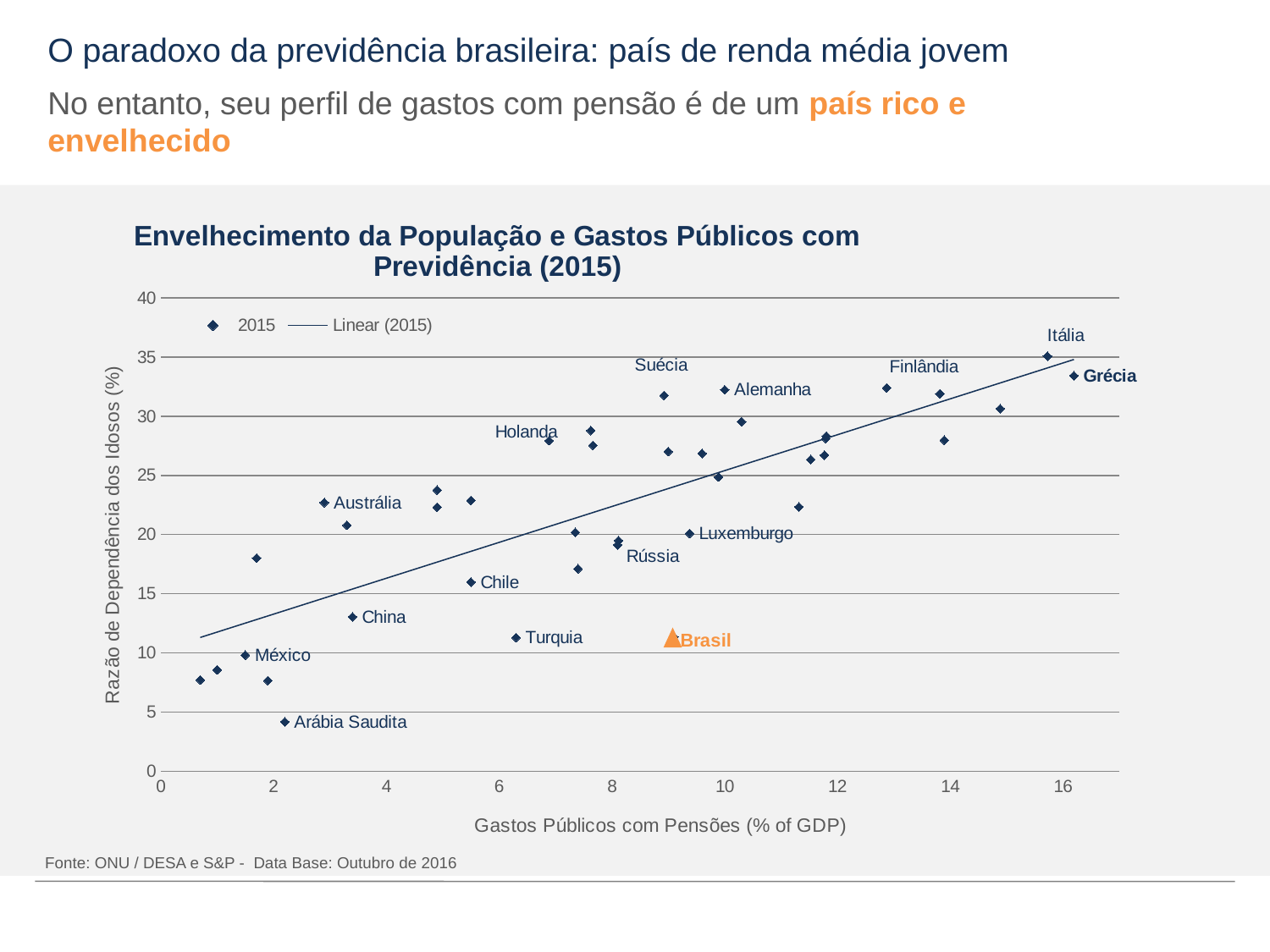
What is the title of the chart? Envelhecimento da População e Gastos Públicos com Previdência (2015) How many entries does the chart legend list? 2 Is the Razão de Dependência dos Idosos value for Brasil greater or less than 15? less What is the label of the x axis? Gastos Públicos com Pensões (% of GDP) Is the Razão de Dependência dos Idosos value for Austrália greater or less than 20? greater Which has a higher Razão de Dependência dos Idosos, Holanda or Chile? Holanda What kind of chart is shown on the slide? Scatter chart Does the trend line show the Razão de Dependência dos Idosos rising or falling as Gastos Públicos com Pensões increases? Rising Is the Razão de Dependência dos Idosos value for Arábia Saudita greater or less than 5? less Which labeled country has the lowest Razão de Dependência dos Idosos? Arábia Saudita